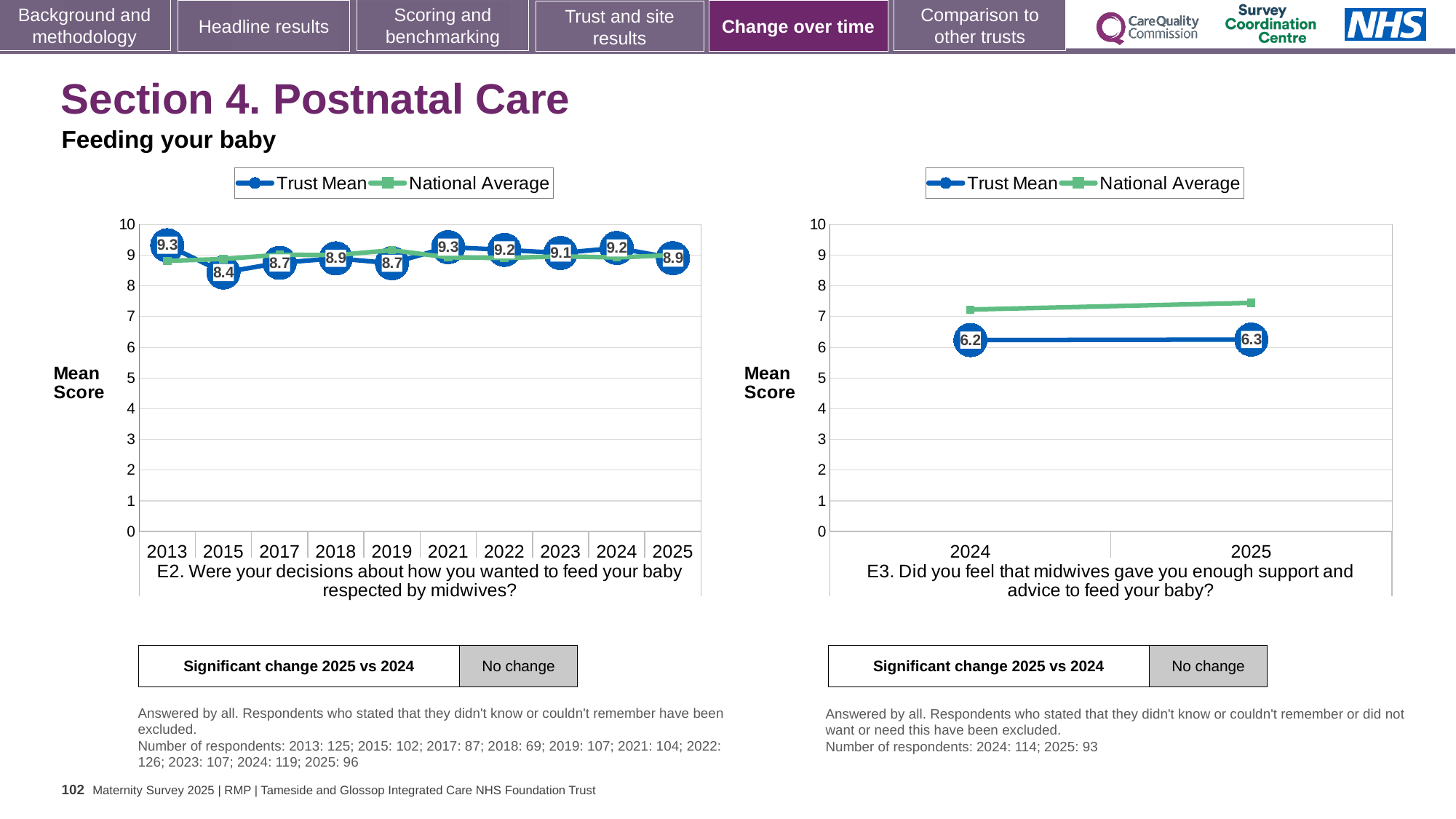
In the E3 chart on the right, what is the Trust Mean for 2024? 6.2 What kind of chart is the E2 chart on the left? Line chart In the E2 chart on the left, which year has the lowest Trust Mean? 2015 In the E2 chart on the left, what is the Trust Mean for 2015? 8.4 What is the y-axis label on the E2 chart on the left? Mean Score How many years are plotted on the x axis of the E2 chart on the left? 10 In the E3 chart on the right, which is higher in 2025, the Trust Mean or the National Average? National Average In the E2 chart on the left, what is the difference between the Trust Mean for 2024 and 2025? 0.3 How many series does the legend of the E3 chart on the right list? 2 In the E3 chart on the right, is the National Average for 2024 greater or less than 7? greater In the E3 chart on the right, does the Trust Mean rise or fall from 2024 to 2025? Rise In the E2 chart on the left, what is the Trust Mean for 2025? 8.9